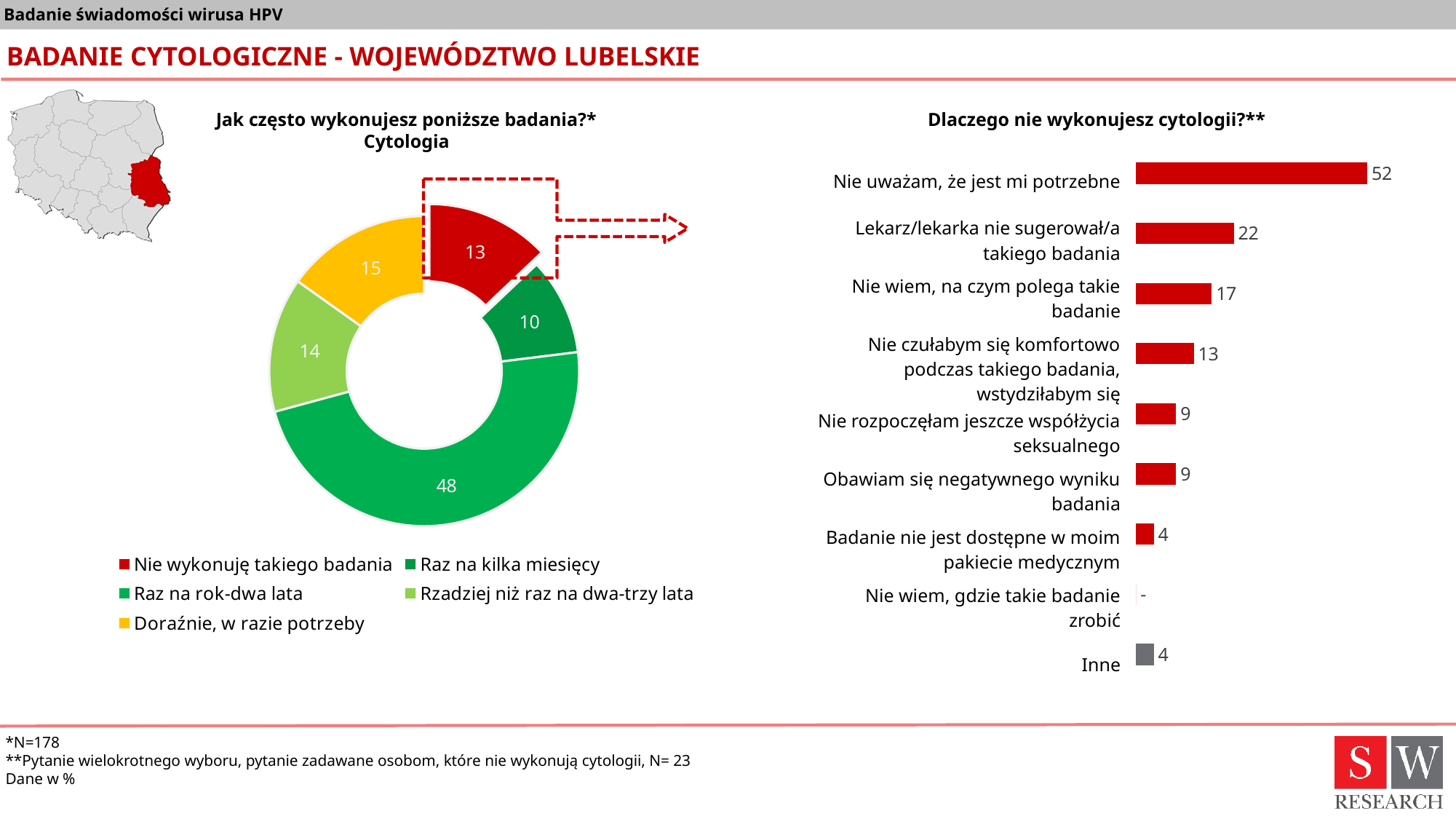
In the bar chart 'Dlaczego nie wykonujesz cytologii?', what is the difference between 'Nie uważam, że jest mi potrzebne' and 'Nie wiem, na czym polega takie badanie'? 35 What type of chart is the chart on the right, 'Dlaczego nie wykonujesz cytologii?'? bar chart In the bar chart 'Dlaczego nie wykonujesz cytologii?', which is larger: 'Nie czułabym się komfortowo podczas takiego badania, wstydziłabym się' or 'Obawiam się negatywnego wyniku badania'? Nie czułabym się komfortowo podczas takiego badania, wstydziłabym się In the doughnut chart 'Jak często wykonujesz poniższe badania? Cytologia', what is the value for 'Raz na rok-dwa lata'? 48 How many categories are shown in the bar chart 'Dlaczego nie wykonujesz cytologii?'? 9 In the doughnut chart on the left, what is the value for 'Nie wykonuję takiego badania'? 13 In the doughnut chart on the left, what is the difference between 'Doraźnie, w razie potrzeby' and 'Rzadziej niż raz na dwa-trzy lata'? 1 In the bar chart 'Dlaczego nie wykonujesz cytologii?', what is the value for 'Lekarz/lekarka nie sugerował/a takiego badania'? 22 In the doughnut chart on the left, which category has the smallest value? Raz na kilka miesięcy In the bar chart 'Dlaczego nie wykonujesz cytologii?', what is the value for 'Inne'? 4 How many categories does the legend of the doughnut chart on the left list? 5 In the bar chart 'Dlaczego nie wykonujesz cytologii?', which category has the highest value? Nie uważam, że jest mi potrzebne